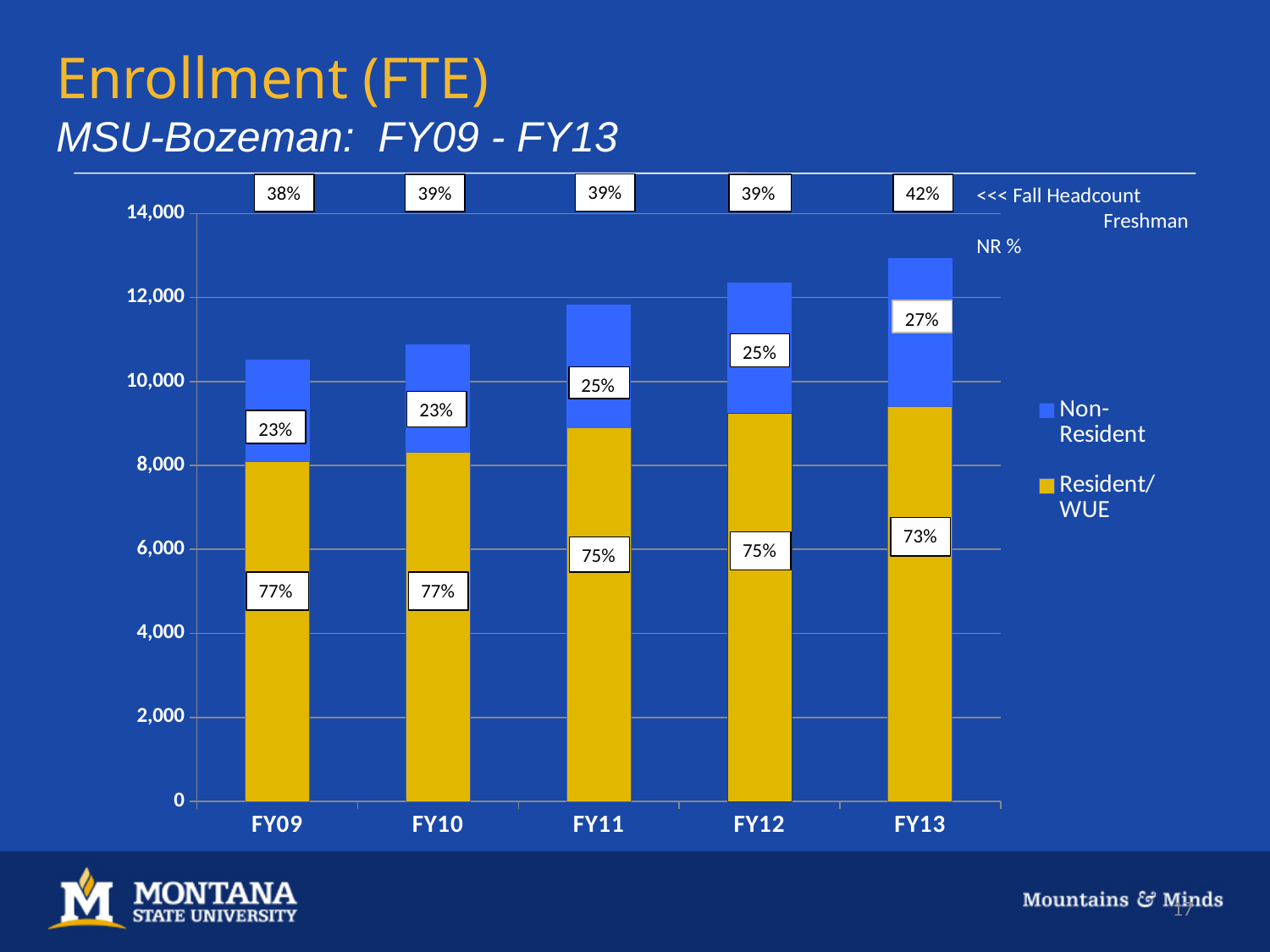
Is the total bar for FY13 greater or less than 12,000? greater What percentage label is shown on the Non-Resident segment for FY13? 27% What is the Fall Headcount Freshman NR % shown above the FY09 bar? 38% How many fiscal years are shown on the x axis of the chart? 5 How many series does the chart legend list? 2 What type of chart is shown on the slide? Stacked bar chart Which fiscal year has the tallest total bar? FY13 What is the Fall Headcount Freshman NR % shown above the FY13 bar? 42% Which fiscal year has the shortest total bar? FY09 What percentage label is shown on the Resident/WUE segment for FY11? 75% Is the total bar for FY10 greater or less than 12,000? less Do the total bar heights rise or fall from FY09 to FY13? rise